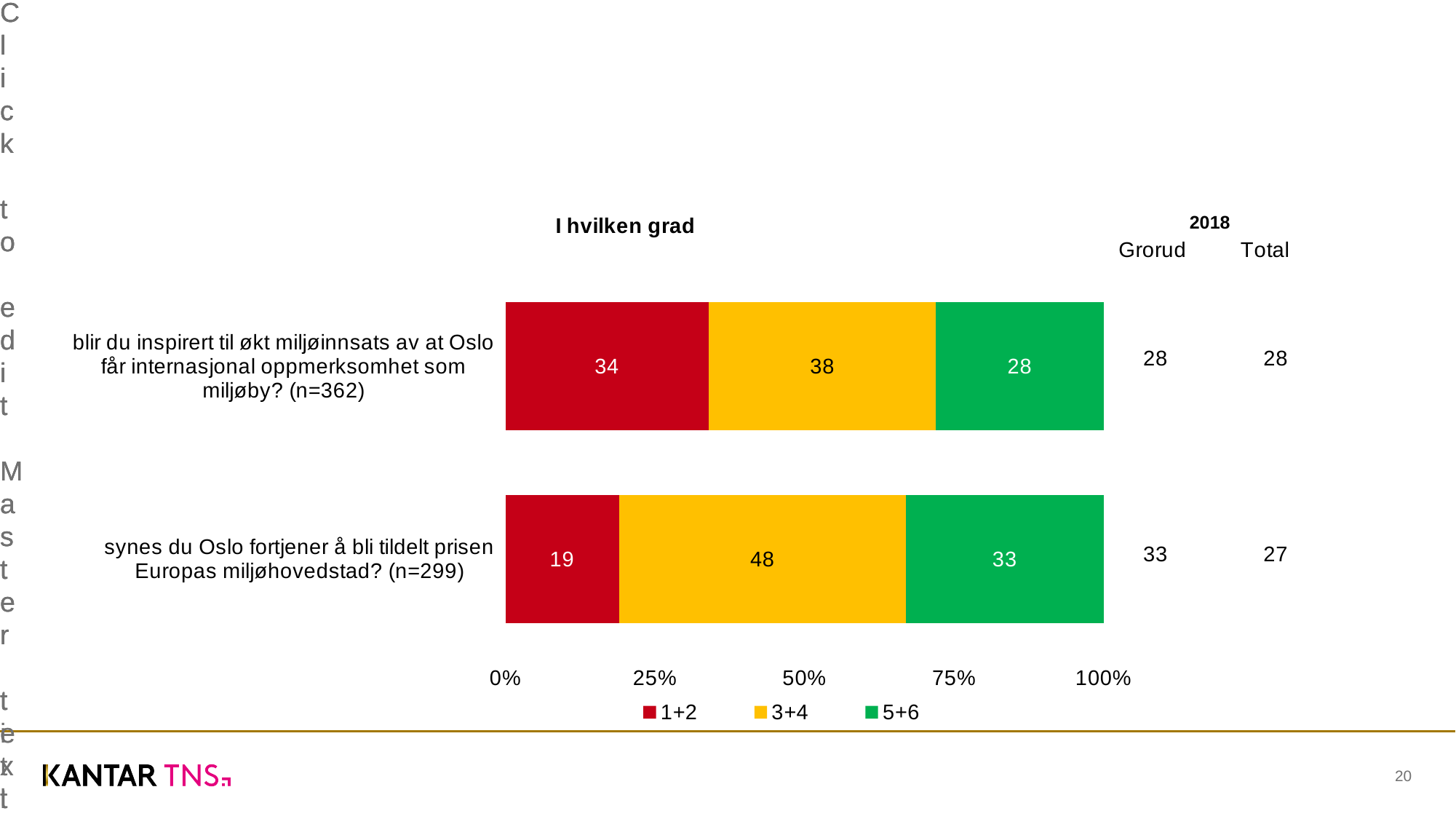
What is the difference between the 1+2 values of the two questions (34 vs 19)? 15 Which question has the larger 5+6 value: 'blir du inspirert til økt miljøinnsats...' or 'synes du Oslo fortjener å bli tildelt prisen...'? synes du Oslo fortjener å bli tildelt prisen Europas miljøhovedstad? (n=299) What is the value of the 1+2 segment for 'synes du Oslo fortjener å bli tildelt prisen Europas miljøhovedstad? (n=299)'? 19 How many series does the legend list? 3 What is the value of the 5+6 segment for 'blir du inspirert til økt miljøinnsats av at Oslo får internasjonal oppmerksomhet som miljøby? (n=362)'? 28 How many categories (questions) are plotted in the chart? 2 Which segment is the smallest in the bar for 'synes du Oslo fortjener å bli tildelt prisen Europas miljøhovedstad? (n=299)'? 1+2 What is the value of the 1+2 segment for 'blir du inspirert til økt miljøinnsats av at Oslo får internasjonal oppmerksomhet som miljøby? (n=362)'? 34 What colour represents the 5+6 series in the legend? green What is the value of the 3+4 segment for 'synes du Oslo fortjener å bli tildelt prisen Europas miljøhovedstad? (n=299)'? 48 What kind of chart is shown on the slide? stacked bar chart Which segment is the largest in the bar for 'synes du Oslo fortjener å bli tildelt prisen Europas miljøhovedstad? (n=299)'? 3+4